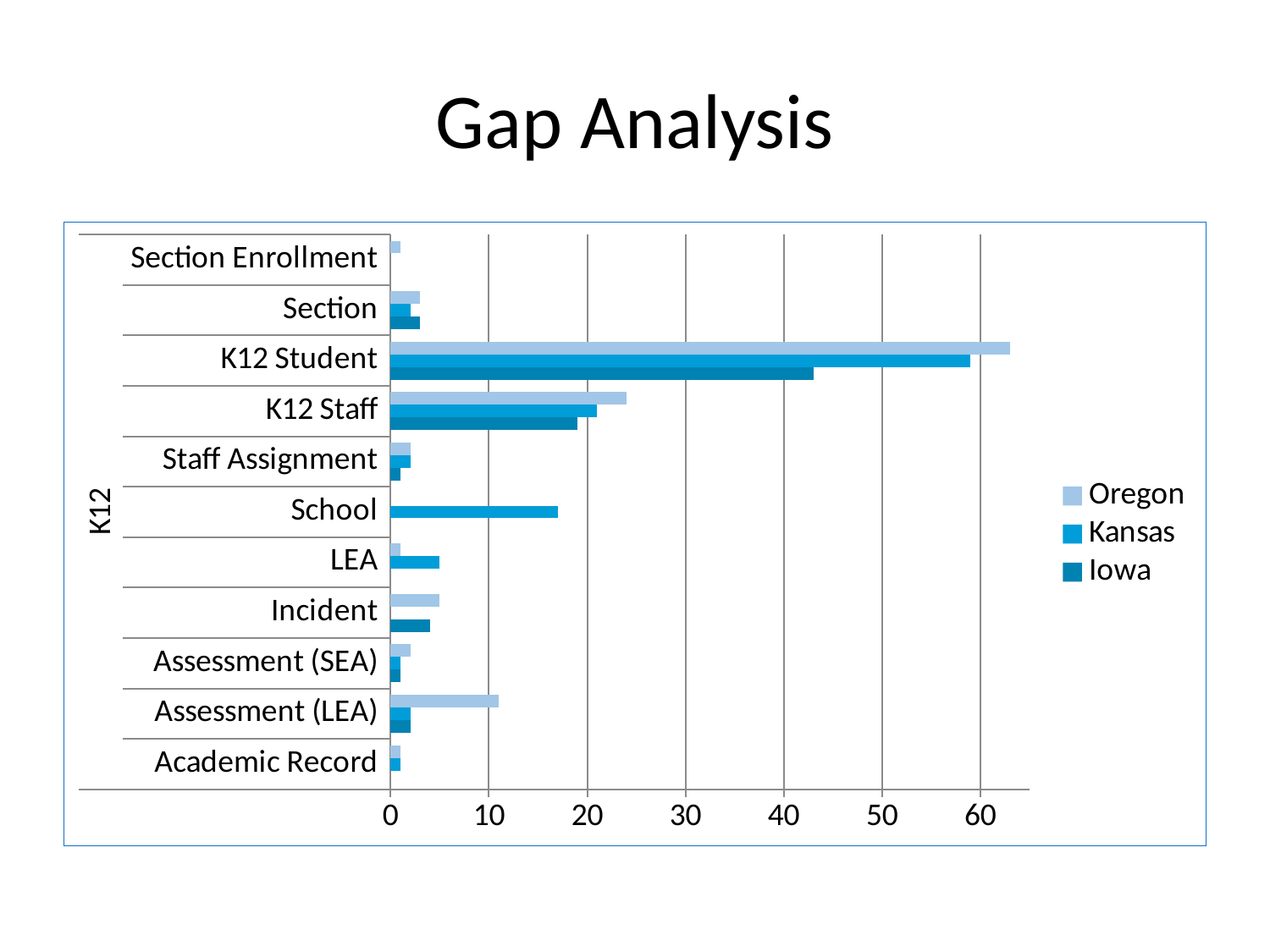
For LEA, which is larger: the Kansas value or the Oregon value? Kansas How many series does the legend list? 3 How many categories are shown on the vertical axis of the chart? 11 Which category has the highest Kansas value? K12 Student What kind of chart is shown on the slide? bar chart For K12 Student, which is larger: the Oregon value or the Iowa value? Oregon Is the Oregon value for K12 Student greater or less than 60? greater What is the title of the chart? Gap Analysis Is the Oregon value for K12 Staff greater or less than 20? greater Which category has the highest Oregon value? K12 Student Is the Kansas value for School greater or less than 20? less